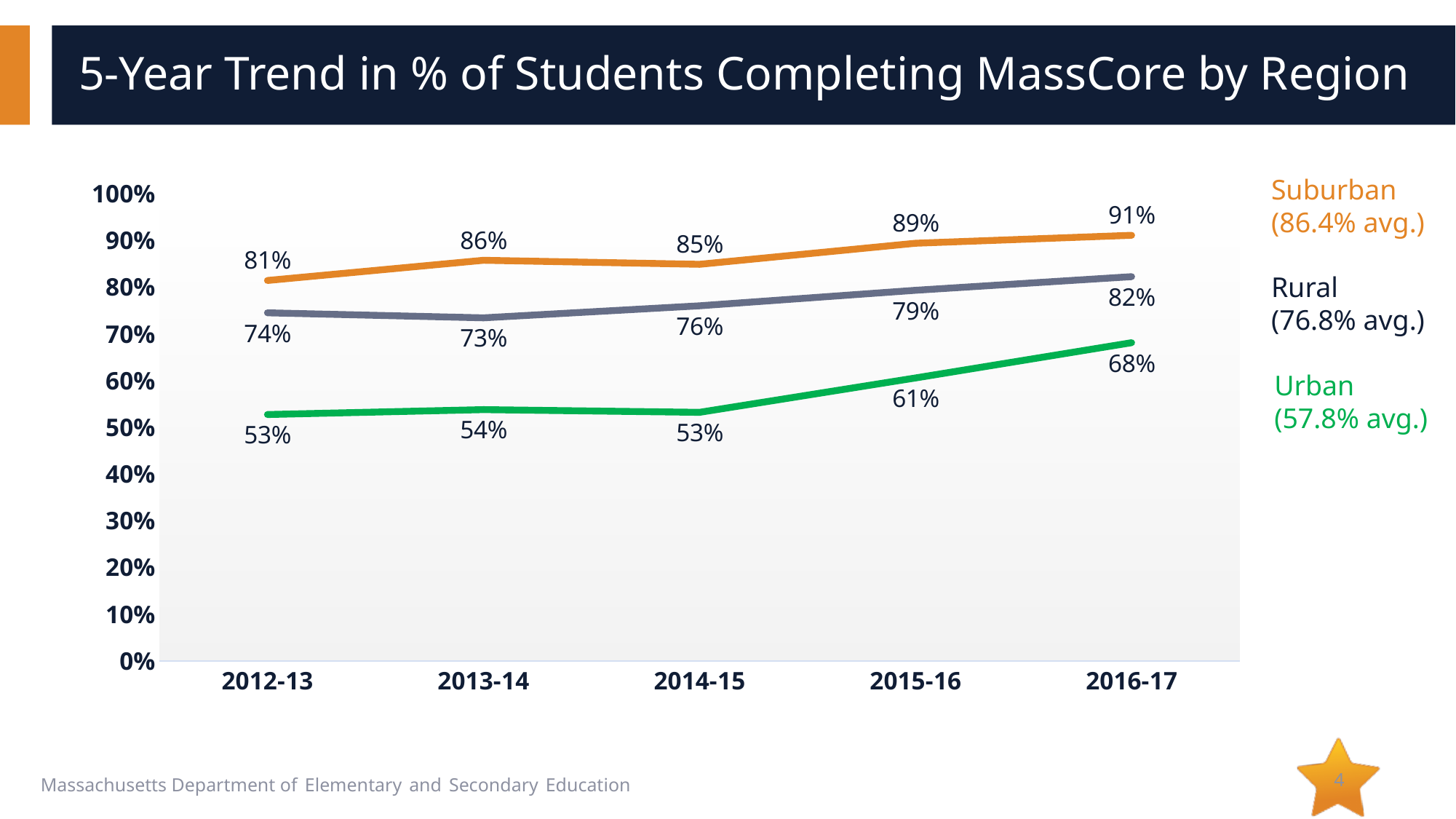
In which year was the Urban percentage highest? 2016-17 By how many percentage points did the Urban value rise from 2014-15 to 2016-17? 15% Which region had the higher percentage in 2014-15, Rural or Urban? Rural What is the 5-year average for the Rural region shown in the legend? 76.8% What kind of chart is shown on the slide? Line chart What was the Suburban percentage of students completing MassCore in 2016-17? 91% What is the difference between the Suburban and Urban percentages in 2012-13? 28% How many school years are shown on the x axis? 5 In which year was the Rural percentage lowest? 2013-14 What was the Urban percentage of students completing MassCore in 2013-14? 54% How many regions (series) are plotted on the chart? 3 What was the Rural percentage of students completing MassCore in 2015-16? 79%